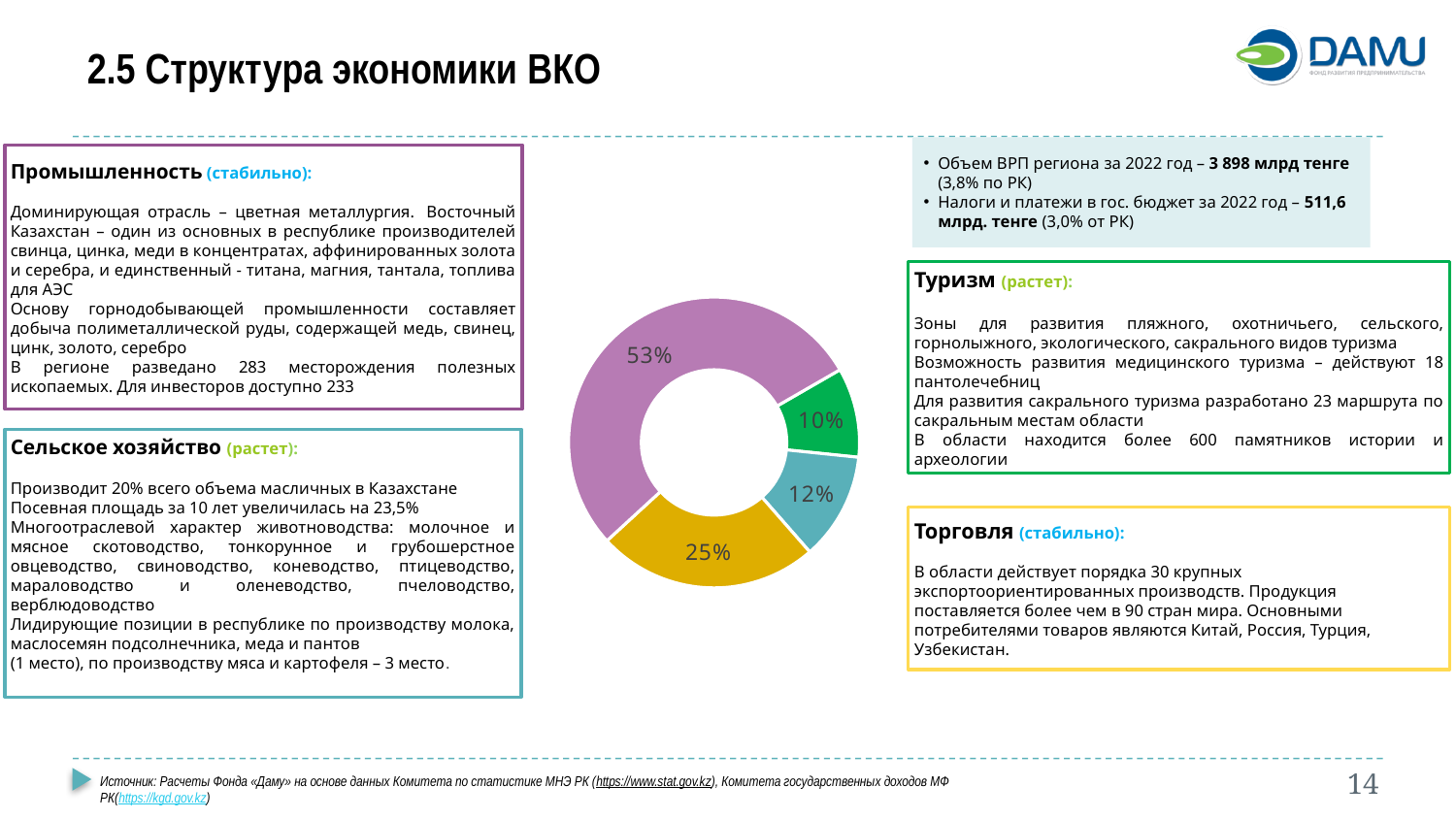
What value is shown on the teal slice of the doughnut chart? 12% What value is shown on the green slice of the doughnut chart? 10% How many slices does the doughnut chart have? 4 What is the difference between the largest slice (53%) and the yellow slice (25%) in the doughnut chart? 28% What is the value of the smallest slice in the doughnut chart? 10% What is the value of the largest slice in the doughnut chart? 53% Which is larger in the doughnut chart, the teal slice or the green slice? The teal slice (12%) What is the combined share of the green and teal slices in the doughnut chart? 22% What value is shown on the purple slice of the doughnut chart? 53% What kind of chart is shown on the slide? Doughnut chart What value is shown on the yellow slice of the doughnut chart? 25% Which colour is the largest slice of the doughnut chart? Purple